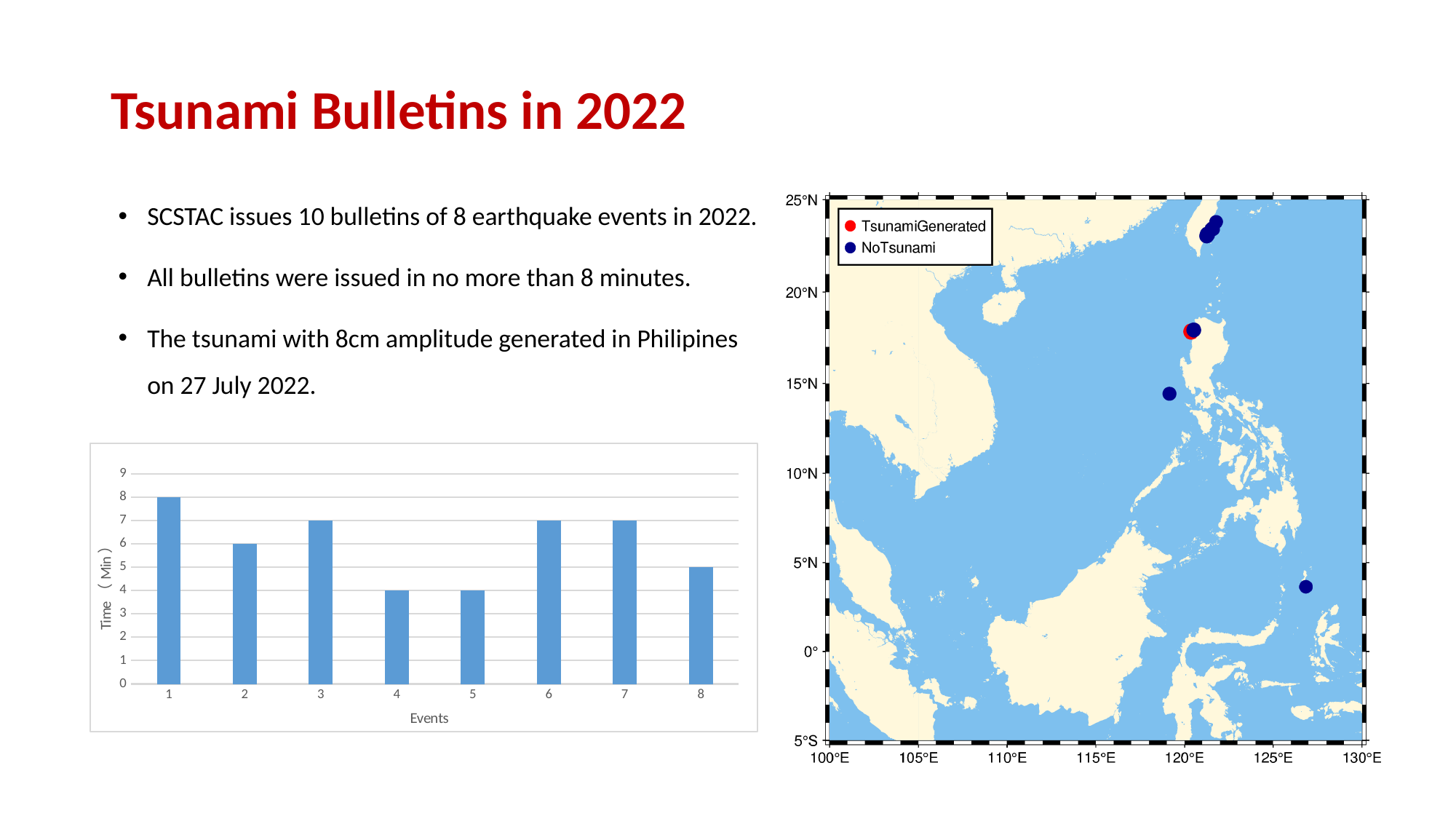
In the bar chart on the left, which has a larger time, event 2 or event 3? Event 3 In the bar chart on the left, is the value for event 6 greater or less than 5? greater How many events are shown in the bar chart on the left? 8 In the bar chart on the left, what is the time in minutes for event 8? 5 How many entries does the legend of the map on the right list? 2 In the bar chart on the left, what is the time in minutes for event 4? 4 In the bar chart on the left, which events have the lowest time? Events 4 and 5 In the bar chart on the left, what is the difference in minutes between event 1 and event 2? 2 In the bar chart on the left, what is the time in minutes for event 1? 8 What is the y-axis label of the bar chart on the left? Time (Min) What kind of chart is shown on the left of the slide? Bar chart In the bar chart on the left, which event has the highest time? Event 1